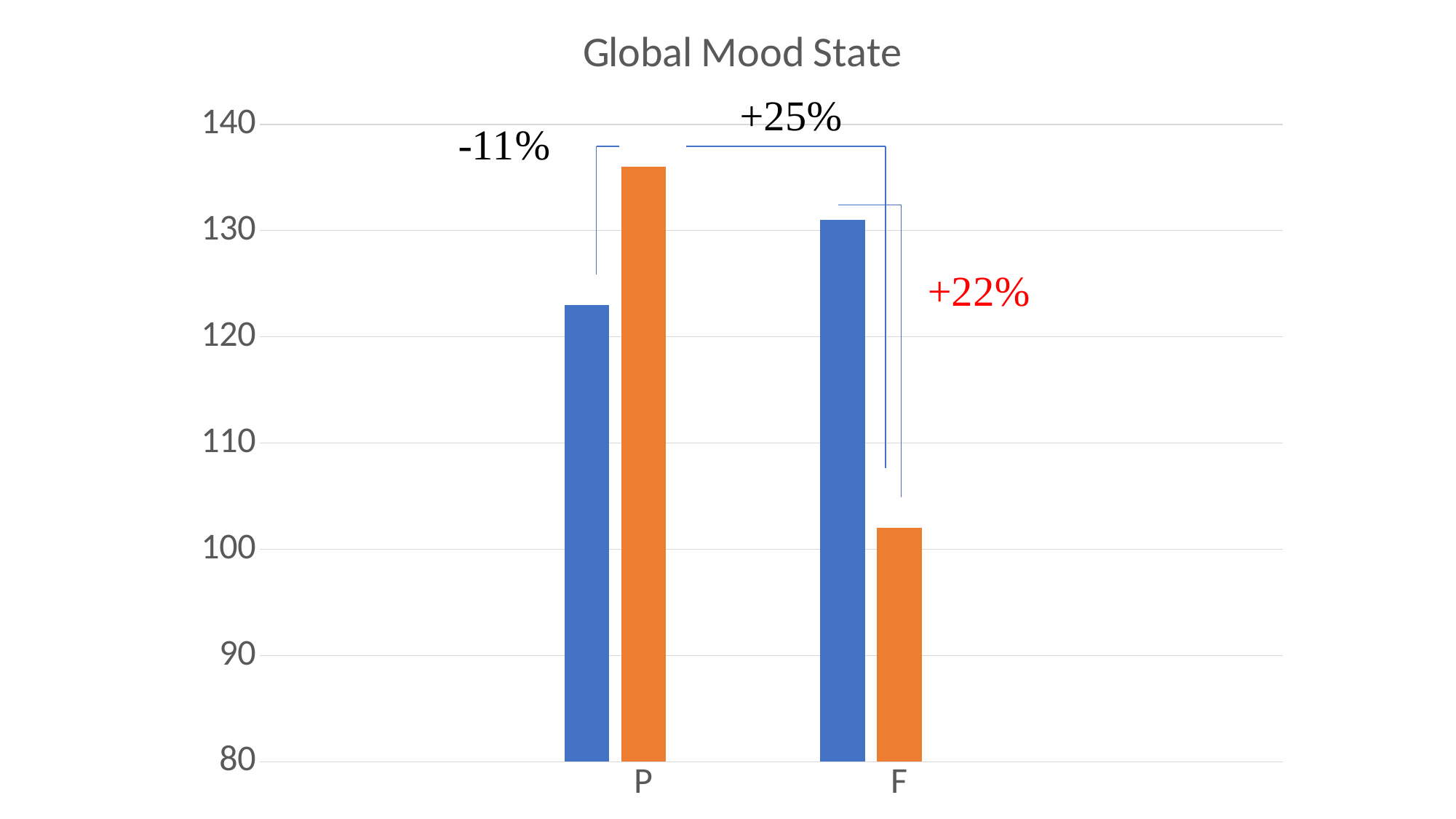
What is the title of the chart? Global Mood State Is the value of the blue bar for P greater or less than 120? greater Which category has the tallest orange bar? P What kind of chart is shown on the slide? bar chart Which category has the shortest orange bar? F Does the orange series rise or fall from P to F? fall Is the value of the orange bar for P greater or less than 130? greater For category P, which bar is taller, the blue bar or the orange bar? the orange bar Is the value of the orange bar for F greater or less than 110? less How many categories are shown on the x axis of the chart? 2 For category F, which bar is taller, the blue bar or the orange bar? the blue bar